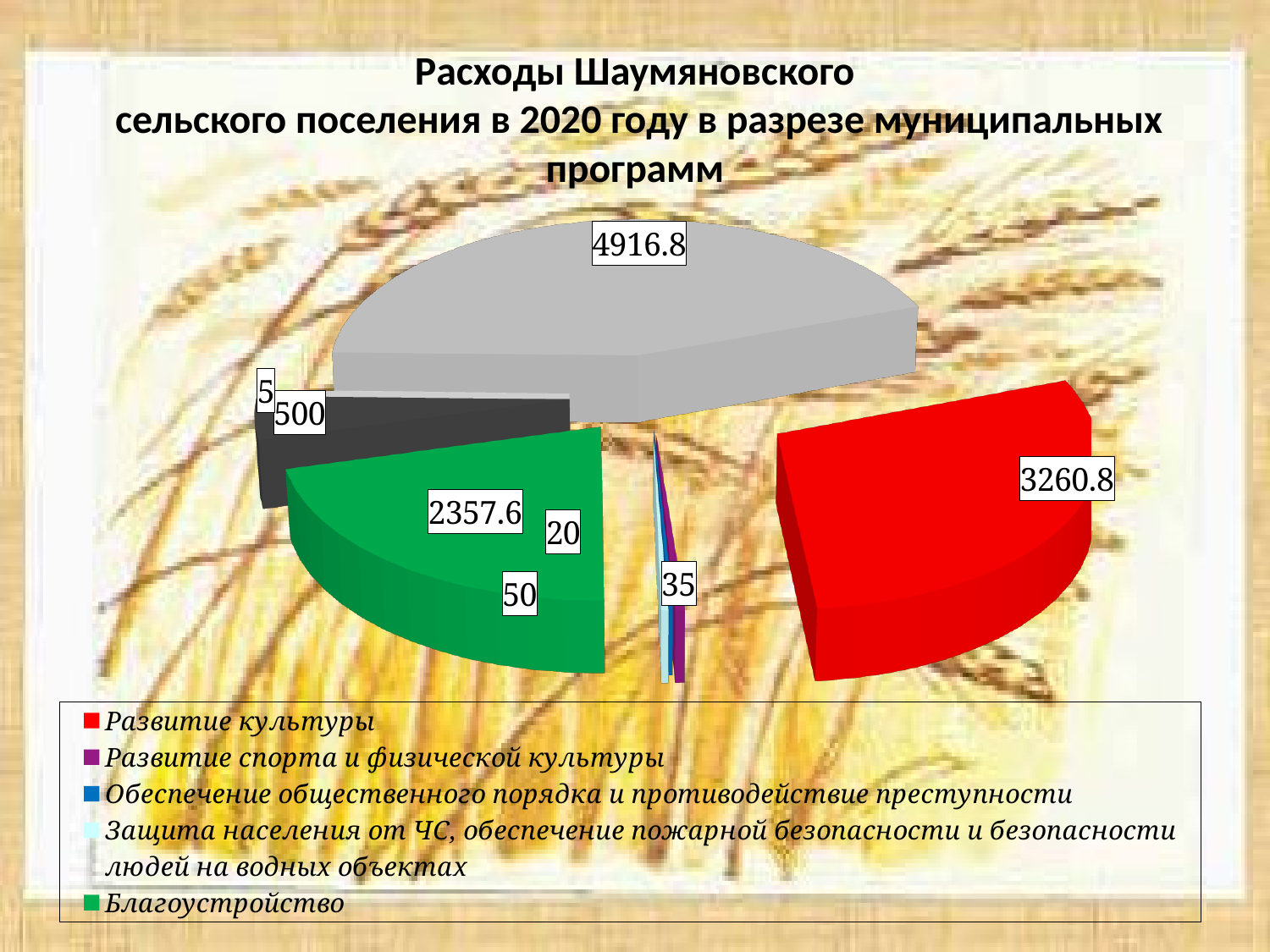
Which year do the expenditures in the chart title refer to? 2020 What kind of chart is shown on the slide? pie chart What is the value shown for Благоустройство (the green slice)? 2357.6 Which is larger, the value for Развитие культуры or the value for Благоустройство? Развитие культуры How many entries does the legend list? 5 What is the difference between the values for Развитие культуры (3260.8) and Благоустройство (2357.6)? 903.2 Is the value for Благоустройство greater or less than 2500? less What is the largest value labelled on the pie chart? 4916.8 What is the value shown for Развитие культуры (the red slice)? 3260.8 What is the value printed on the large grey slice at the top of the pie? 4916.8 What colour represents Благоустройство in the chart? green Is the value for Развитие культуры greater or less than 3000? greater